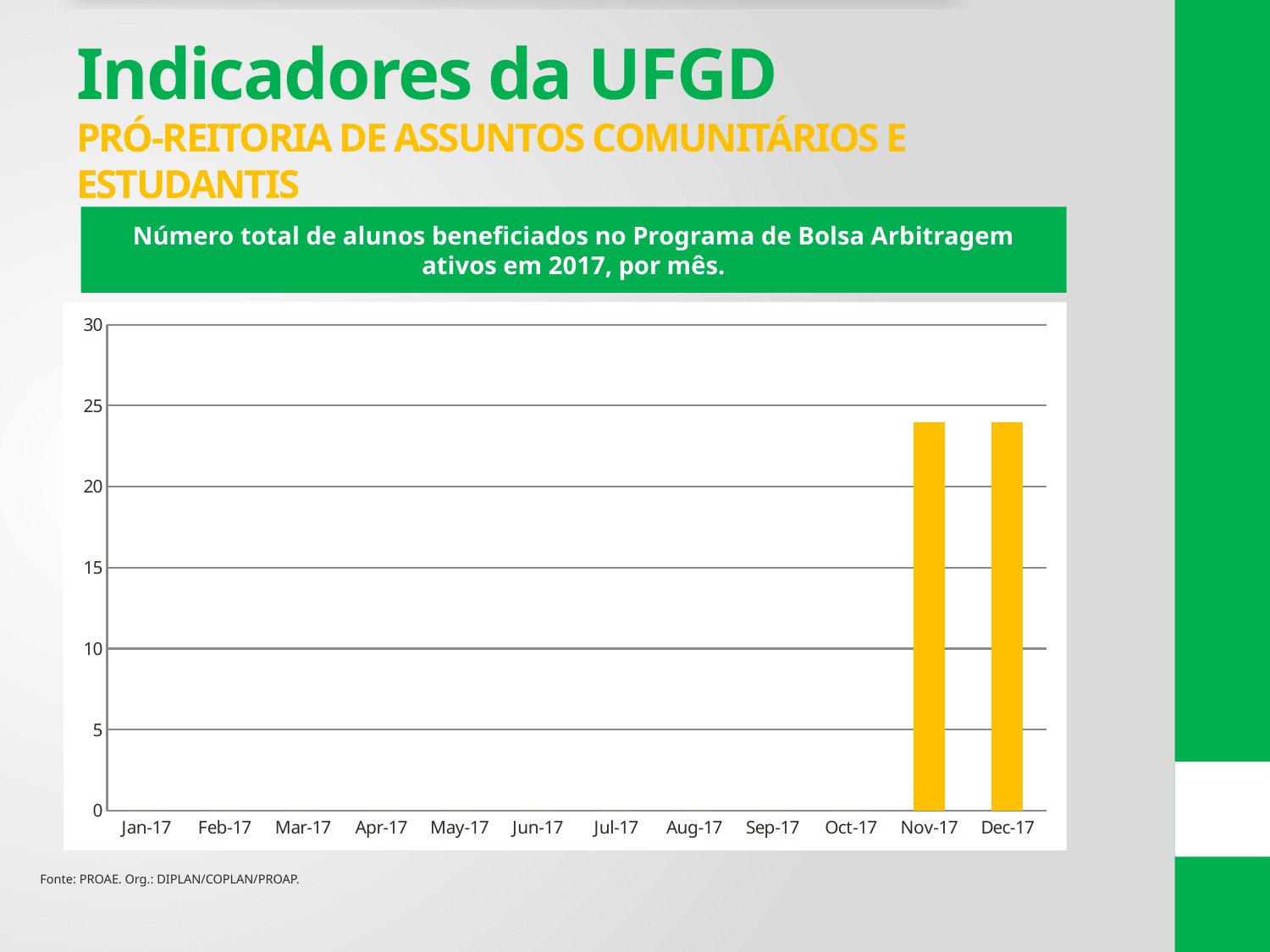
Which is larger, the value for Dec-17 or the value for Oct-17? Dec-17 Is the value for Dec-17 greater or less than 10? greater Which months have a visible bar in the chart? Nov-17 and Dec-17 Which is larger, the value for Nov-17 or the value for Jan-17? Nov-17 Is the value for Nov-17 greater or less than 15? greater Is the value for Dec-17 greater or less than 25? less What kind of chart is shown on the slide? bar chart What is the highest value shown on the y axis of the chart? 30 How many months show a visible bar in the chart? 2 What is the title of the chart? Número total de alunos beneficiados no Programa de Bolsa Arbitragem ativos em 2017, por mês. How many months are shown on the x axis of the chart? 12